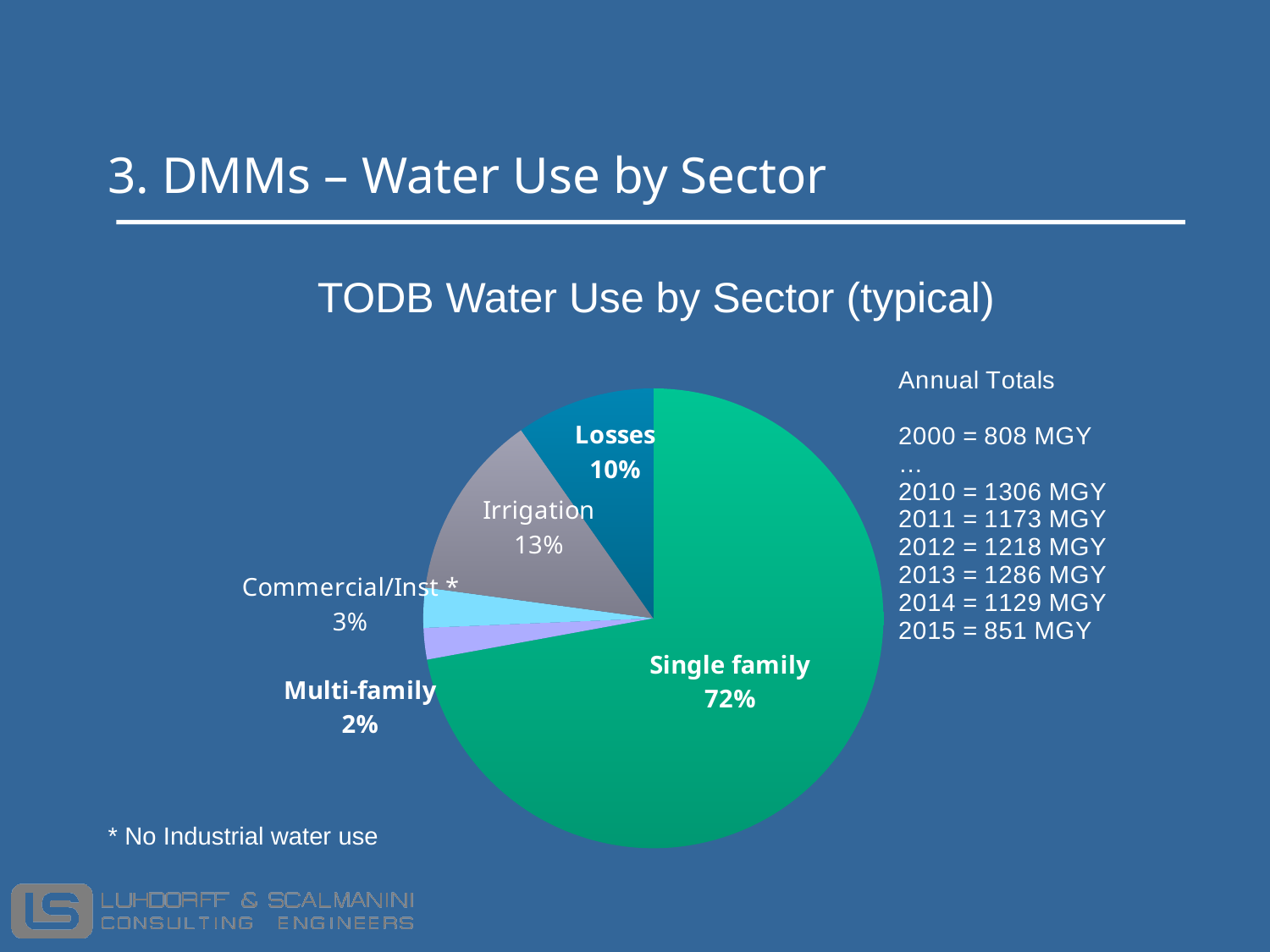
What percentage is shown for Commercial/Inst *? 3% How many sectors are shown in the pie chart? 5 Which sector has the smallest share of the pie? Multi-family What percentage is shown for Losses? 10% Which sector has the largest share of the pie? Single family What is the difference in percentage points between Irrigation and Losses? 3 What percentage is shown for Multi-family? 2% What share of the pie does Single family account for? 72% Which is larger, the share for Losses or the share for Commercial/Inst *? Losses What is the title of the chart? TODB Water Use by Sector (typical) What percentage is shown for Irrigation? 13% What kind of chart is shown on the slide? Pie chart